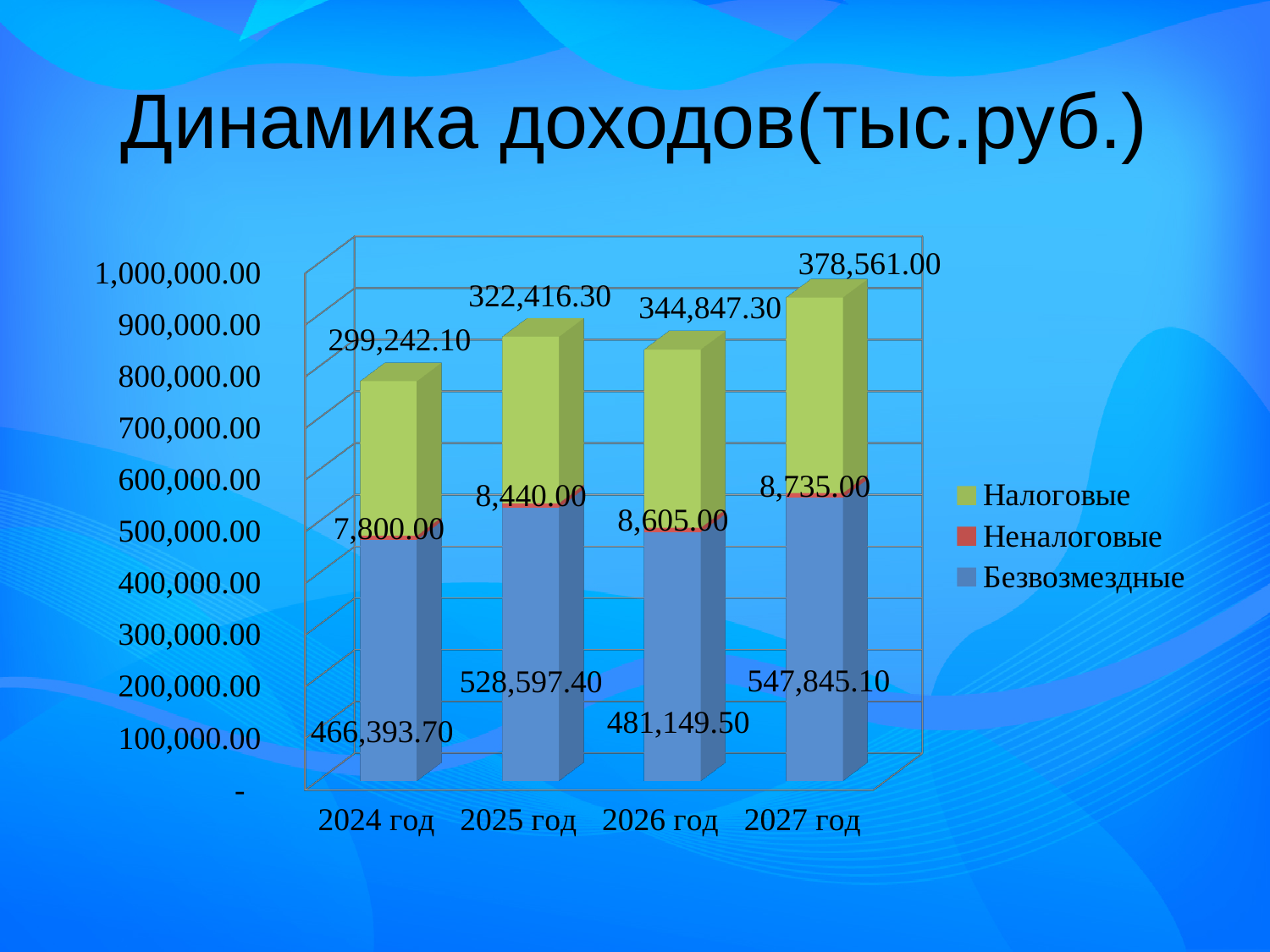
How many years (categories) are shown on the x axis? 4 How many series does the legend list? 3 What is the title of the chart? Динамика доходов(тыс.руб.) What is the total of the stacked bar for 2024 год? 773,435.80 What is the value of Безвозмездные for 2026 год? 481,149.50 What type of chart is shown on the slide? Stacked bar chart Which is larger: Безвозмездные for 2025 год or for 2026 год? 2025 год In which year is the Безвозмездные value lowest? 2024 год What is the value of Налоговые for 2025 год? 322,416.30 In which year is the Налоговые value highest? 2027 год What is the value of Неналоговые for 2024 год? 7,800.00 What is the difference between the Налоговые values for 2027 год and 2024 год? 79,318.90